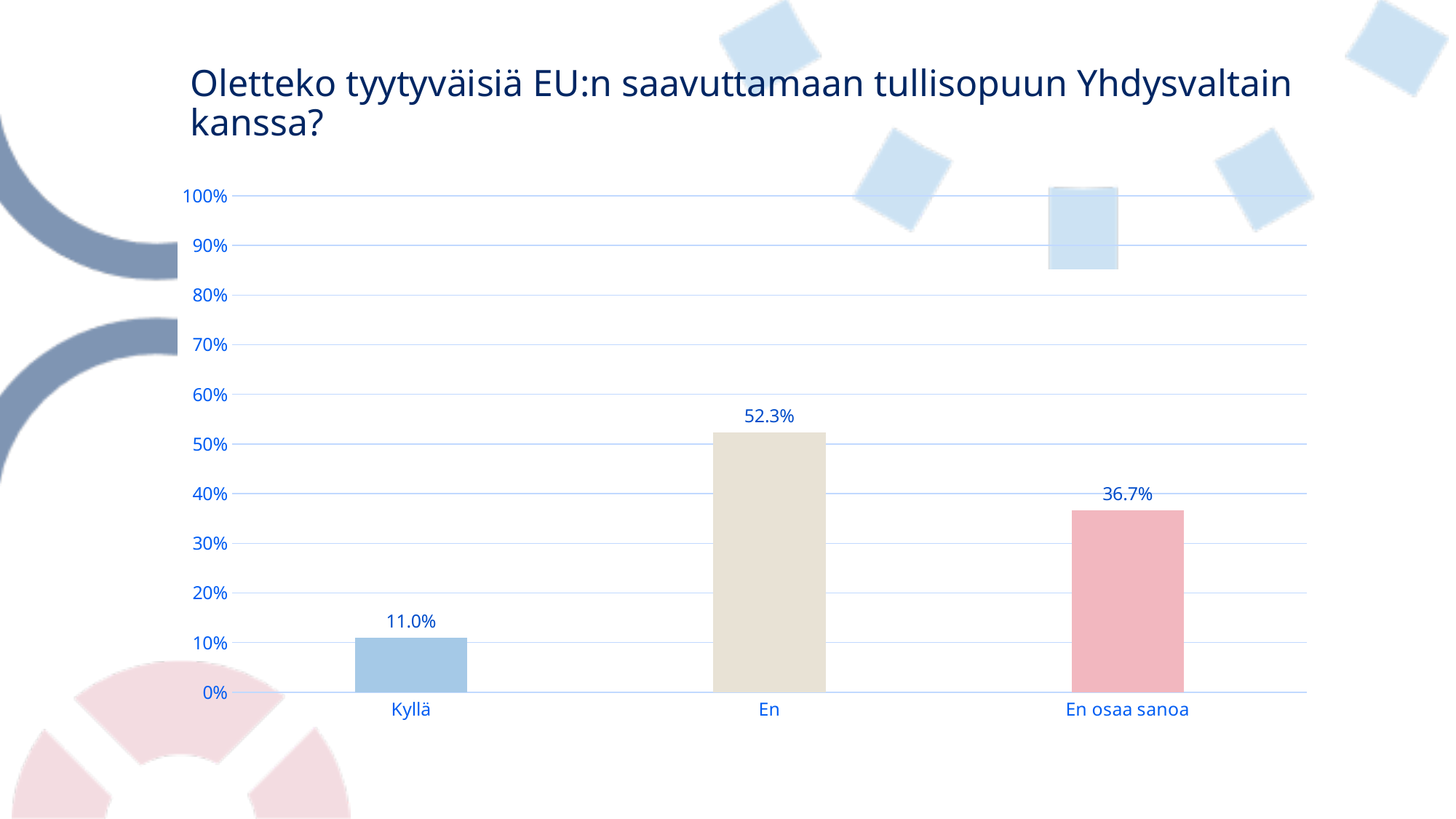
What is the value for En? 52.3% Which category has the lowest value? Kyllä What is the difference between the values for En osaa sanoa and Kyllä? 25.7% What is the value for Kyllä? 11.0% Which category has the highest value? En What is the title of the slide? Oletteko tyytyväisiä EU:n saavuttamaan tullisopuun Yhdysvaltain kanssa? What is the value for En osaa sanoa? 36.7% What kind of chart is shown on the slide? bar chart What is the difference between the values for En and En osaa sanoa? 15.6% How many categories are shown on the x axis? 3 Which is larger, the value for Kyllä or the value for En osaa sanoa? En osaa sanoa Is the value for En greater or less than 50%? greater